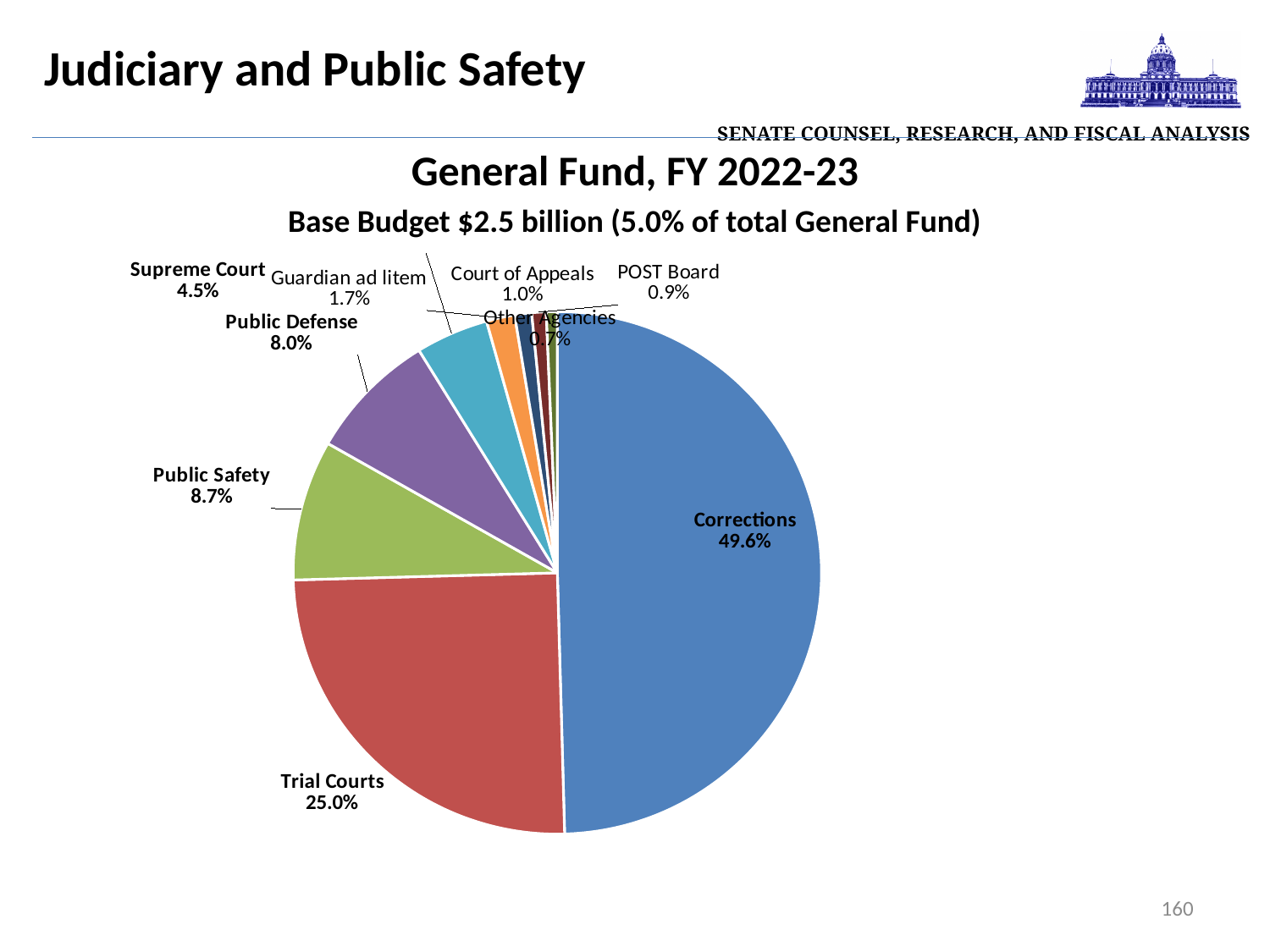
Which category has the largest slice of the pie? Corrections What is the subtitle shown below the chart title 'General Fund, FY 2022-23'? Base Budget $2.5 billion (5.0% of total General Fund) What percentage is shown for Public Defense? 8.0% Which is larger, the share for Public Safety or the share for Public Defense? Public Safety What percentage is shown for Trial Courts? 25.0% What share of the General Fund, FY 2022-23 pie does Corrections account for? 49.6% How many slices does the pie chart have? 9 What kind of chart is shown on the slide? Pie chart What is the difference in percentage points between Corrections and Trial Courts? 24.6 What percentage is shown for the Supreme Court? 4.5% What percentage is shown for Public Safety? 8.7% Which category has the smallest slice of the pie? Other Agencies